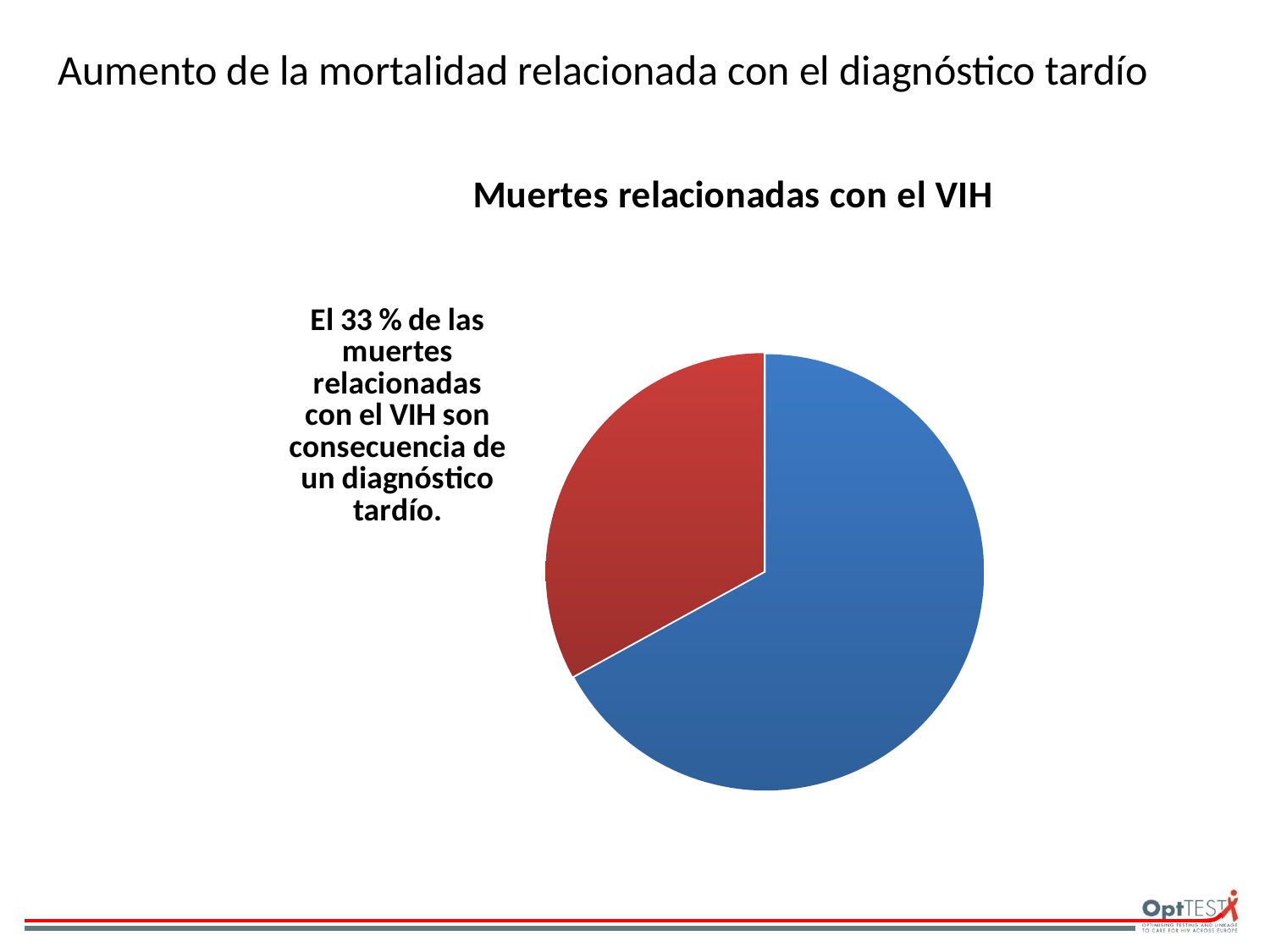
What colour is the slice representing deaths due to late diagnosis? red Is the share of the blue slice greater or less than 50%? greater Is the share of the red slice greater or less than 50%? less What is the title of the chart? Muertes relacionadas con el VIH How many slices does the pie chart have? 2 Which slice of the pie is the smallest? the red slice (diagnóstico tardío) What kind of chart is shown on the slide? pie chart Which slice of the pie is larger, the blue slice or the red slice? blue What share of HIV-related deaths is represented by the blue slice, given the red slice is 33 %? 67 % What share of HIV-related deaths is attributed to late diagnosis (diagnóstico tardío) according to the chart? 33 %